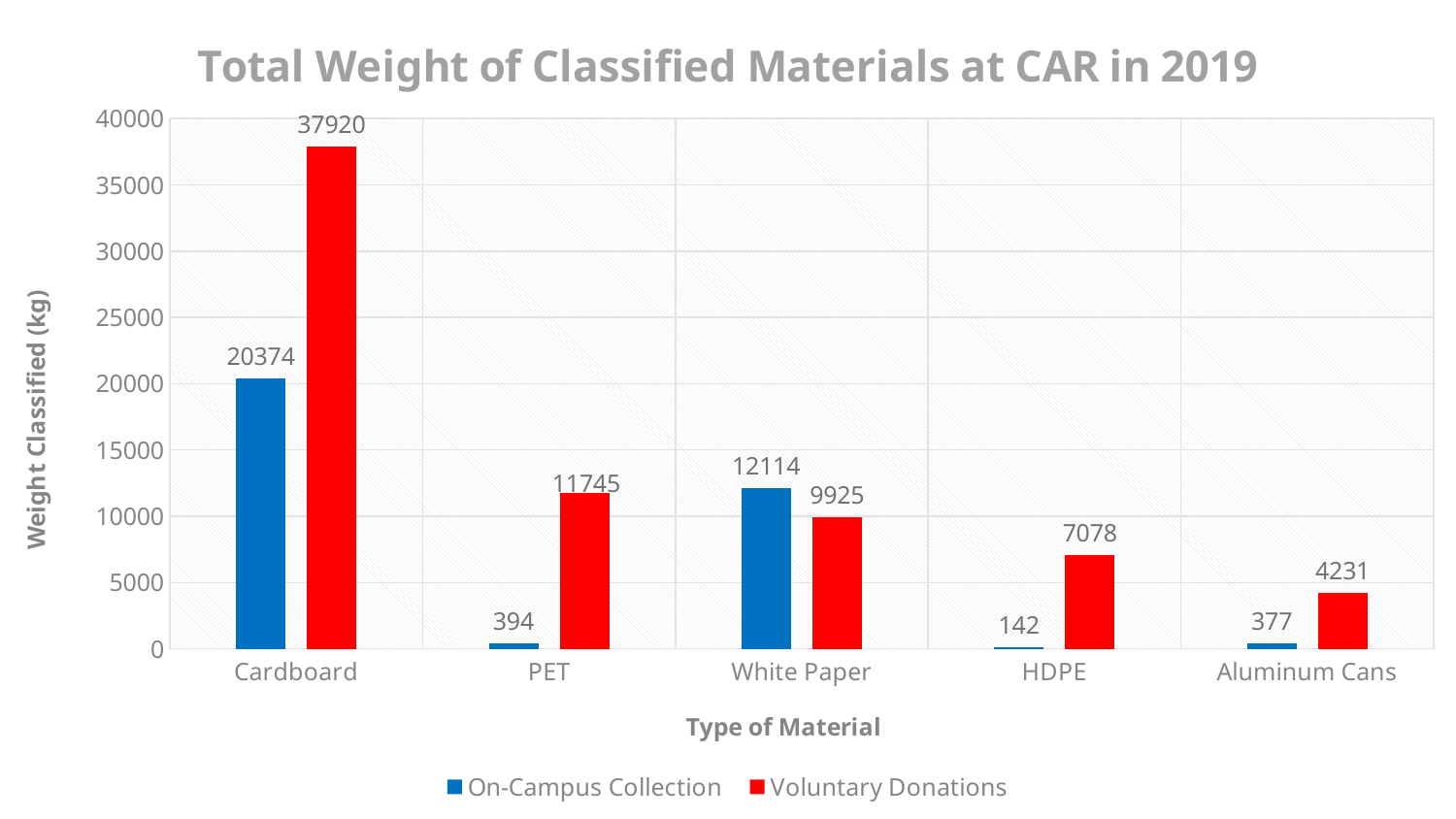
What is the title of the chart? Total Weight of Classified Materials at CAR in 2019 What is the On-Campus Collection value for Aluminum Cans? 377 How many series does the legend list? 2 What is the On-Campus Collection value for Cardboard? 20374 What kind of chart is shown on the slide? Bar chart What is the difference between the Voluntary Donations and On-Campus Collection values for Cardboard? 17546 Which material has the lowest On-Campus Collection value? HDPE Which material has the highest Voluntary Donations value? Cardboard Is the Voluntary Donations value for PET greater or less than 10000? greater What is the Voluntary Donations value for HDPE? 7078 For White Paper, which is larger: On-Campus Collection or Voluntary Donations? On-Campus Collection How many material types are shown on the x axis? 5